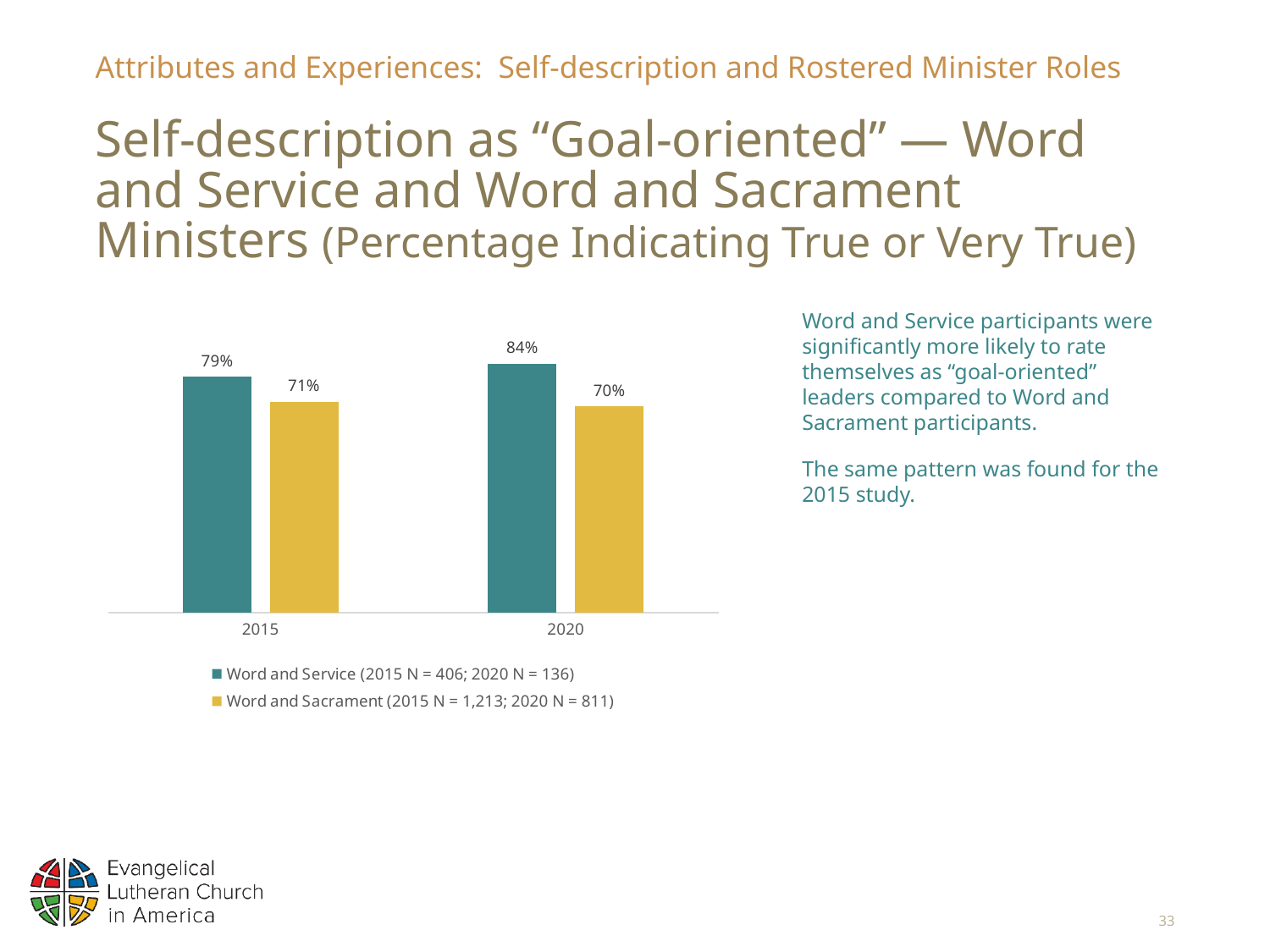
How many series does the legend list? 2 Did the Word and Service value rise or fall from 2015 to 2020? Rise What is the value for Word and Sacrament in 2015? 71% What is the value for Word and Service in 2020? 84% What percentage of Word and Sacrament participants described themselves as goal-oriented in 2020? 70% What percentage of Word and Service participants described themselves as goal-oriented in 2015? 79% What kind of chart is shown on the slide? Bar chart Which bar in the chart has the lowest value? Word and Sacrament, 2020 What is the difference between the Word and Service and Word and Sacrament values in 2015? 8 percentage points Which group had the larger value in 2015, Word and Service or Word and Sacrament? Word and Service Which bar in the chart has the highest value? Word and Service, 2020 What is the difference between the Word and Service and Word and Sacrament values in 2020? 14 percentage points